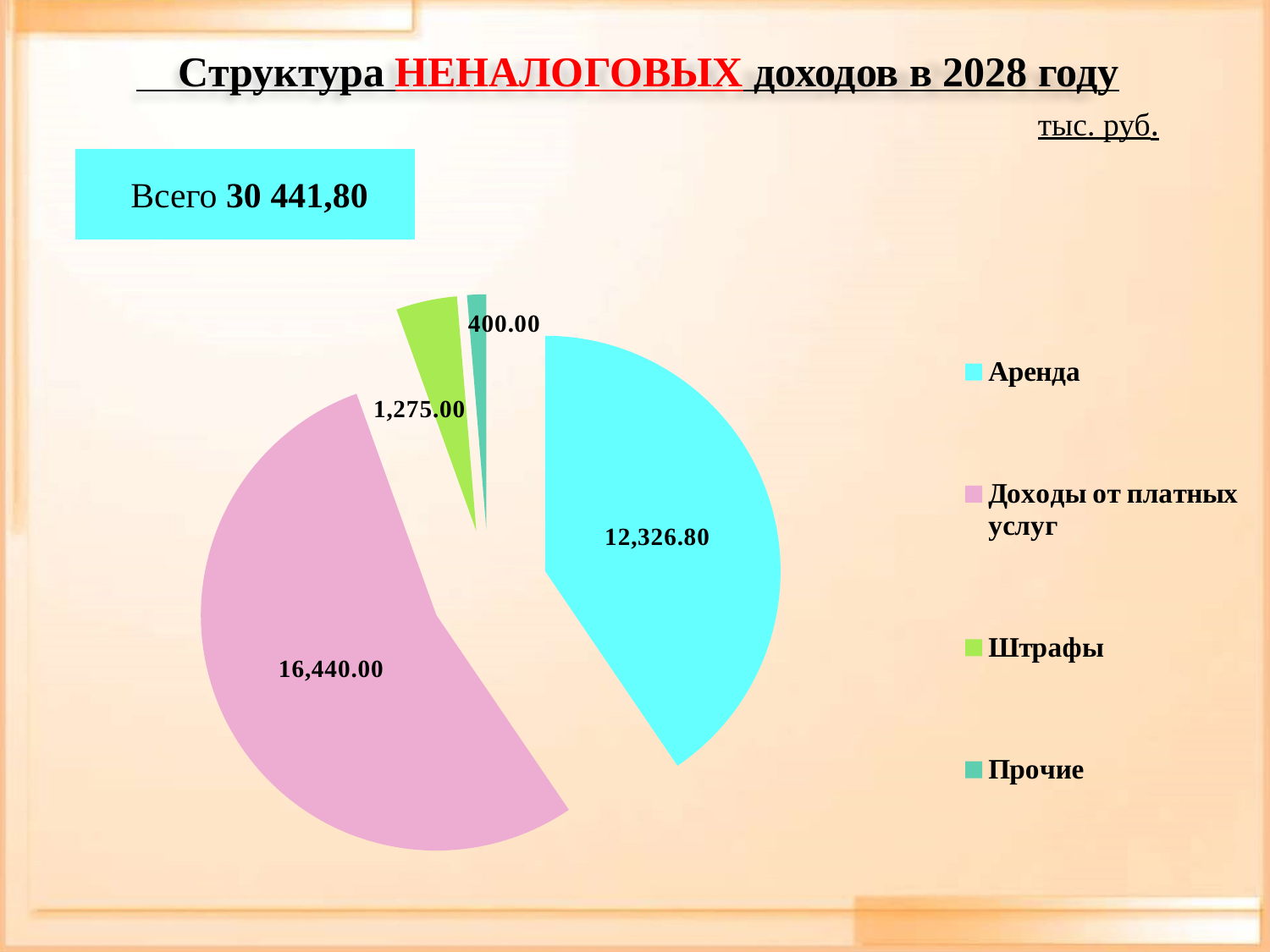
Which category has the largest slice of the pie? Доходы от платных услуг Which category has the smallest slice of the pie? Прочие What total (Всего) is shown on the slide? 30 441,80 What is the value for Аренда? 12,326.80 How many categories does the pie chart have? 4 What is the difference between the values for Штрафы and Прочие? 875.00 What is the value for Прочие? 400.00 What type of chart is shown on the slide? pie chart What is the value for Доходы от платных услуг? 16,440.00 What is the value for Штрафы? 1,275.00 Which is larger, the value for Аренда or the value for Штрафы? Аренда What is the difference between the values for Доходы от платных услуг and Аренда? 4,113.20